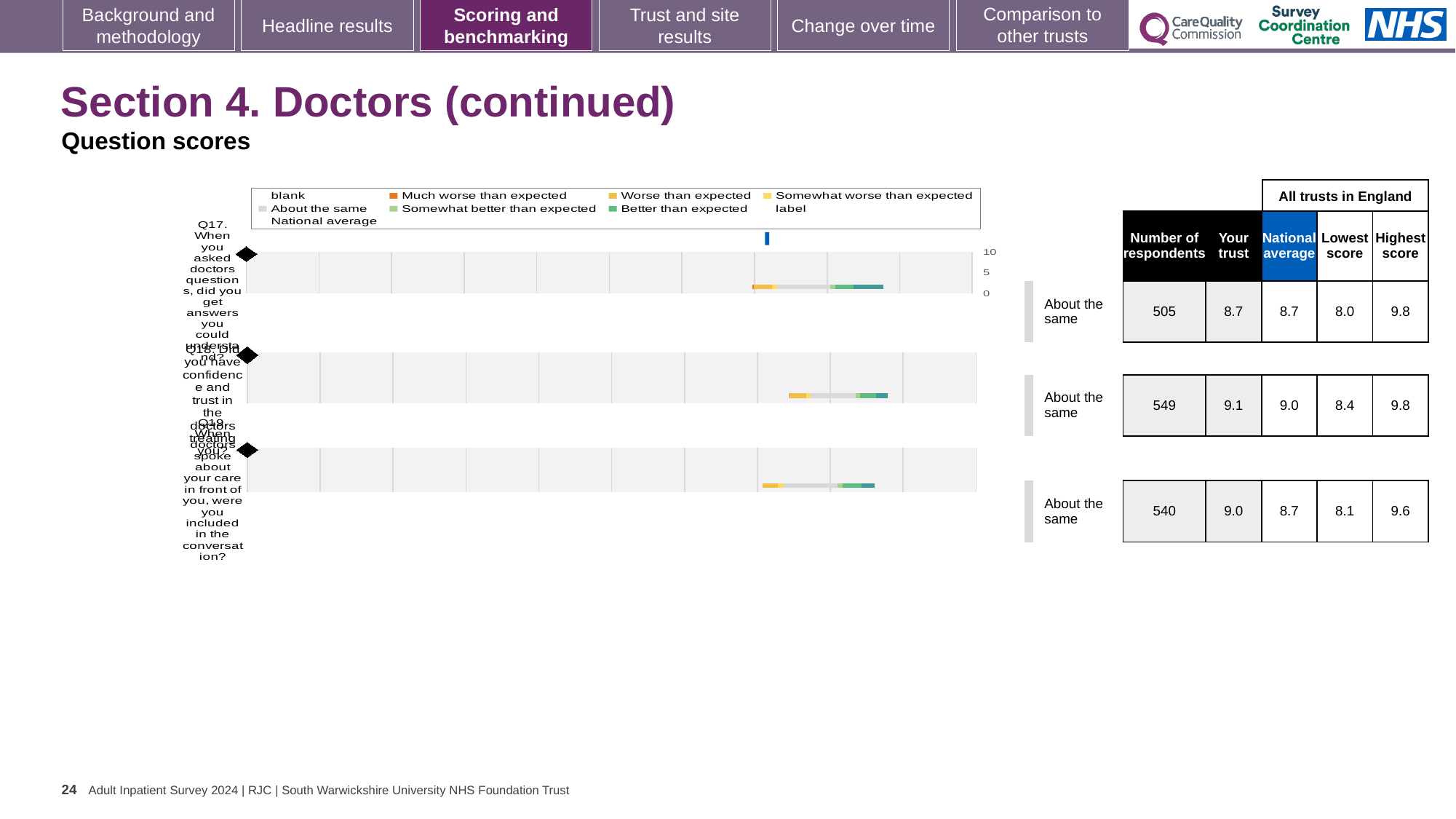
Which question has the lowest 'Your trust' score? Q17 What is the highest value shown on the chart's axis? 10 What is the difference between the 'Your trust' score and the national average for Q19? 0.3 What is the 'Your trust' score for Q18? 9.1 What benchmark category is shown for Q17? About the same What is the lowest score among all trusts in England for Q18? 8.4 How many questions (categories) are plotted in the chart? 3 What is the national average score for Q19? 8.7 Which question has the highest number of respondents? Q18 What is the number of respondents for Q17? 505 How many entries does the chart legend list? 9 What kind of chart is used to show the question scores on this slide? bar chart